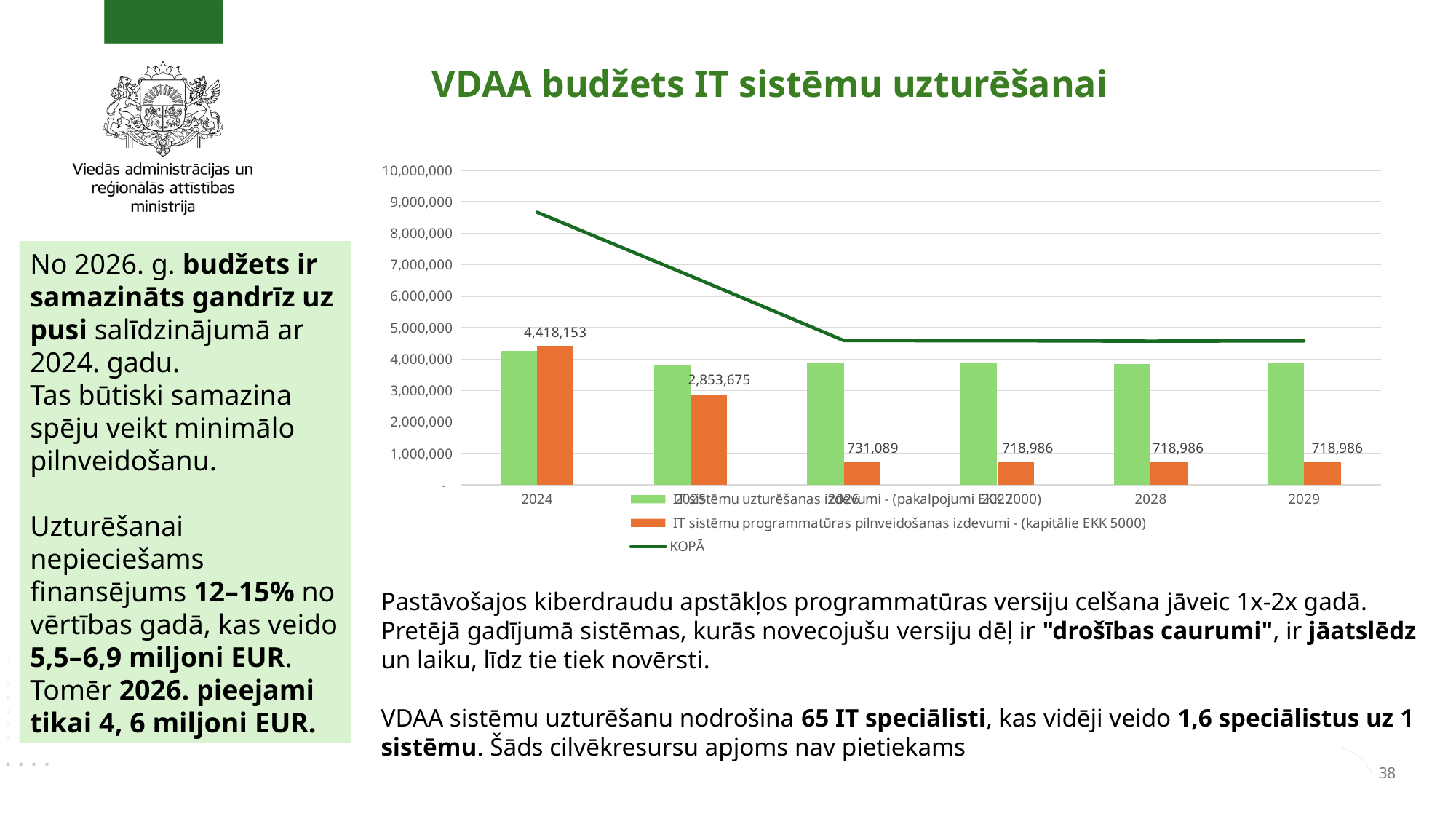
Which is larger for the IT sistēmu programmatūras pilnveidošanas izdevumi (kapitālie EKK 5000) series: the 2025 value or the 2026 value? 2025 Do the values of the IT sistēmu programmatūras pilnveidošanas izdevumi (kapitālie EKK 5000) series rise or fall from 2024 to 2029? fall What is the value of the IT sistēmu programmatūras pilnveidošanas izdevumi (kapitālie EKK 5000) series for 2026? 731,089 How many series does the chart legend list? 3 Is the KOPĀ value for 2024 greater or less than 8,000,000? greater What is the value of the IT sistēmu programmatūras pilnveidošanas izdevumi (kapitālie EKK 5000) series for 2025? 2,853,675 What is the value of the IT sistēmu programmatūras pilnveidošanas izdevumi (kapitālie EKK 5000) series for 2028? 718,986 What is the difference between the 2024 and 2025 values of the IT sistēmu programmatūras pilnveidošanas izdevumi (kapitālie EKK 5000) series? 1,564,478 Is the KOPĀ value for 2027 greater or less than 5,000,000? less What is the value of the IT sistēmu programmatūras pilnveidošanas izdevumi (kapitālie EKK 5000) series for 2024? 4,418,153 In which year is the IT sistēmu programmatūras pilnveidošanas izdevumi (kapitālie EKK 5000) value highest? 2024 How many years are shown on the x axis of the chart? 6